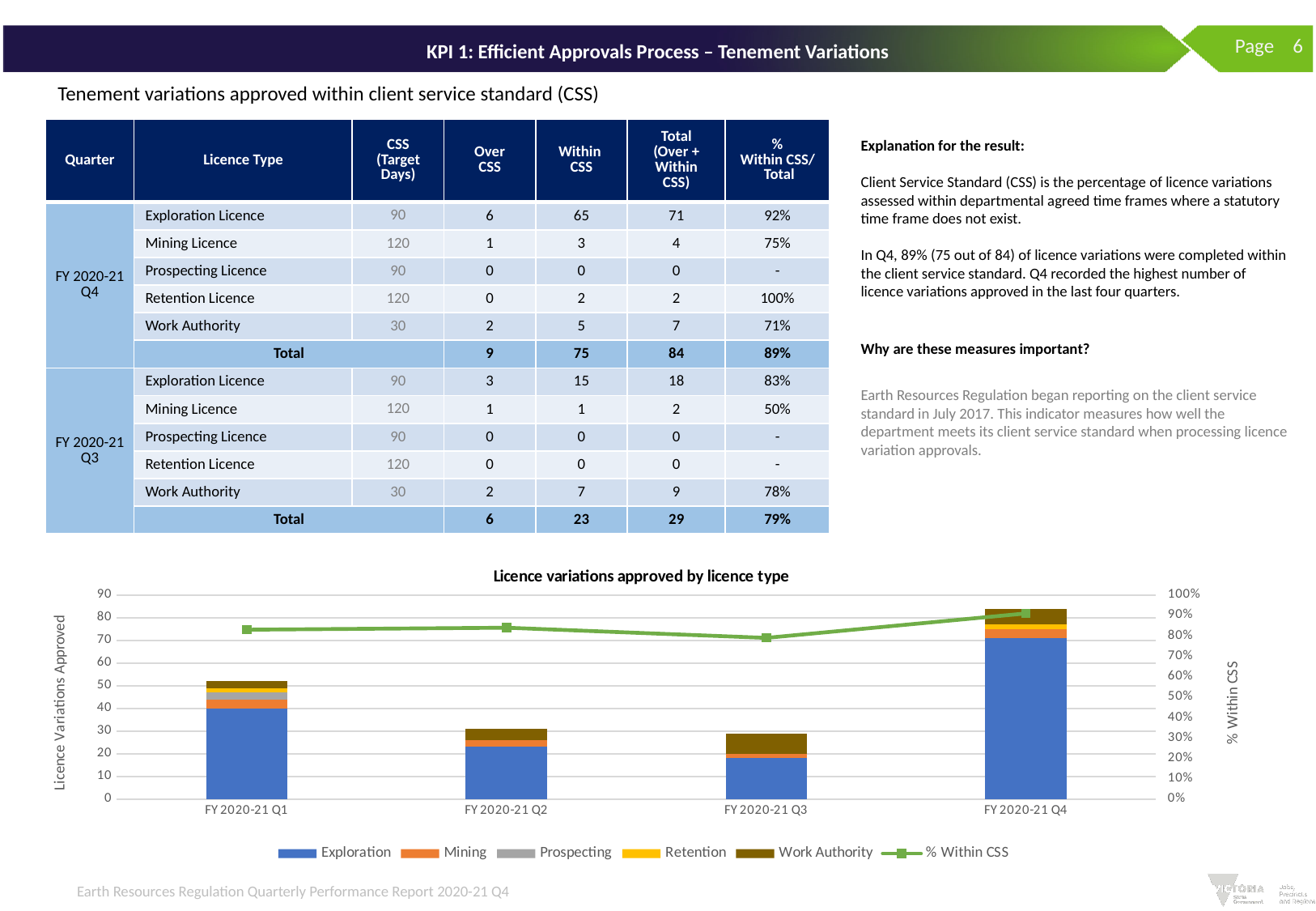
How many quarters are shown on the x axis of the 'Licence variations approved by licence type' chart? 4 In the 'Licence variations approved by licence type' chart, does the '% Within CSS' line rise or fall from FY 2020-21 Q3 to FY 2020-21 Q4? rise In the 'Licence variations approved by licence type' chart, is the '% Within CSS' value for FY 2020-21 Q4 greater or less than 80%? greater In the 'Licence variations approved by licence type' chart, is the total bar for FY 2020-21 Q2 greater or less than 40? less What is the total number of licence variations approved in FY 2020-21 Q4, as shown in the table and plotted in the chart? 84 In the 'Licence variations approved by licence type' chart, is the total bar for FY 2020-21 Q4 greater or less than 80? greater In the 'Licence variations approved by licence type' chart, which stacked bar is taller: FY 2020-21 Q1 or FY 2020-21 Q2? FY 2020-21 Q1 What kind of chart is 'Licence variations approved by licence type'? combination bar and line chart (stacked bars with a line) Which quarter has the tallest stacked bar in the 'Licence variations approved by licence type' chart? FY 2020-21 Q4 How many series does the legend of the 'Licence variations approved by licence type' chart list? 6 In the 'Licence variations approved by licence type' chart, which colour represents the Exploration series? blue